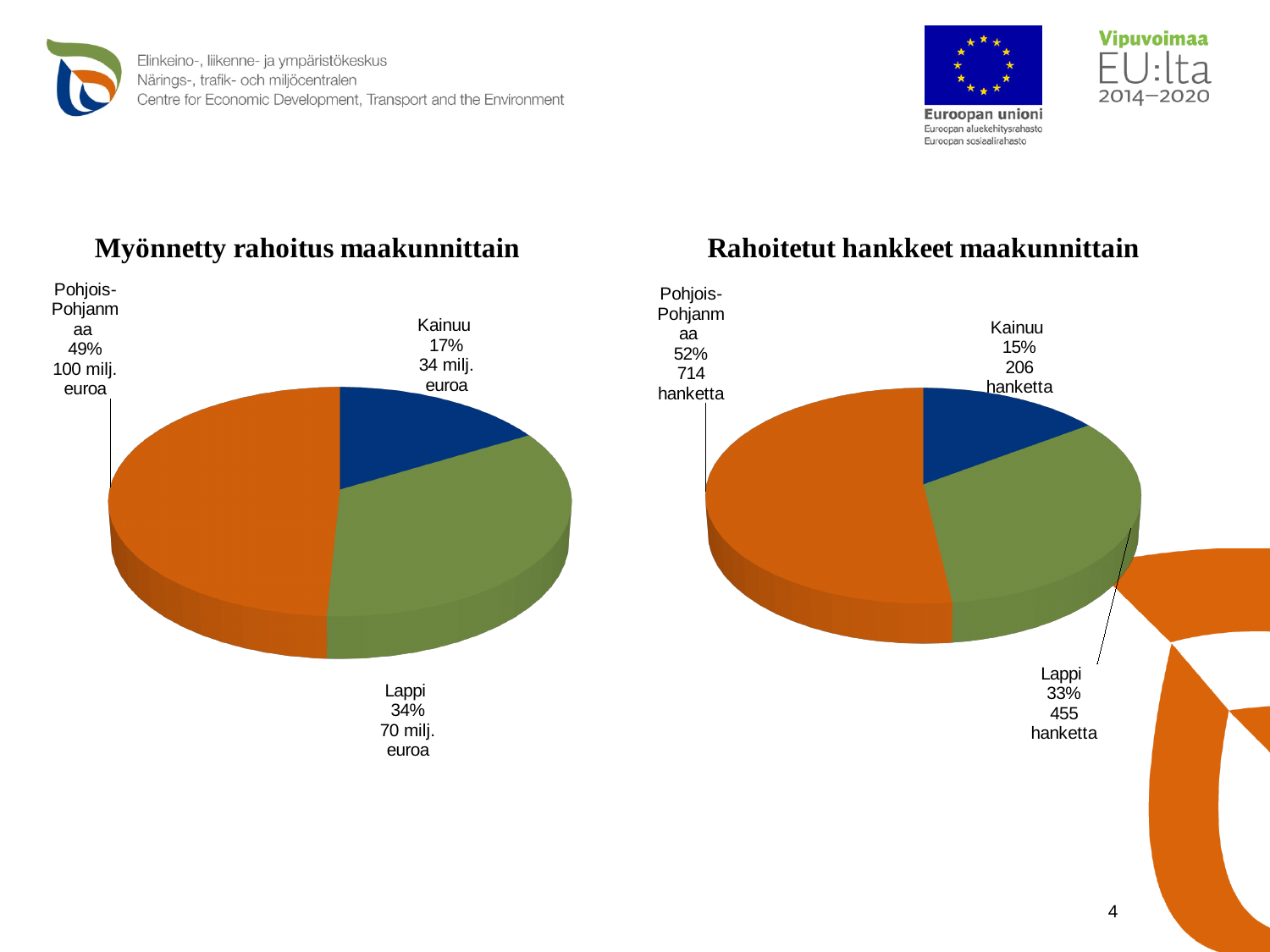
In the chart titled "Rahoitetut hankkeet maakunnittain", what share of the pie does Lappi have? 33% In the chart titled "Rahoitetut hankkeet maakunnittain", which has more projects, Kainuu or Lappi? Lappi In the chart titled "Rahoitetut hankkeet maakunnittain", which region has the largest slice? Pohjois-Pohjanmaa In the chart titled "Rahoitetut hankkeet maakunnittain", how many projects are shown for Pohjois-Pohjanmaa? 714 hanketta In the chart titled "Rahoitetut hankkeet maakunnittain", how many more projects does Lappi have than Kainuu? 249 In the chart titled "Myönnetty rahoitus maakunnittain", what amount is shown for Kainuu? 34 milj. euroa In the chart titled "Myönnetty rahoitus maakunnittain", which region has the smallest slice? Kainuu In the chart titled "Myönnetty rahoitus maakunnittain", how many slices does the pie have? 3 In the chart titled "Myönnetty rahoitus maakunnittain", what amount is shown for Lappi? 70 milj. euroa What is the title of the chart on the right side of the slide? Rahoitetut hankkeet maakunnittain What type of chart is used on the left side of the slide, titled "Myönnetty rahoitus maakunnittain"? Pie chart In the chart titled "Myönnetty rahoitus maakunnittain", what share of the pie does Pohjois-Pohjanmaa have? 49%